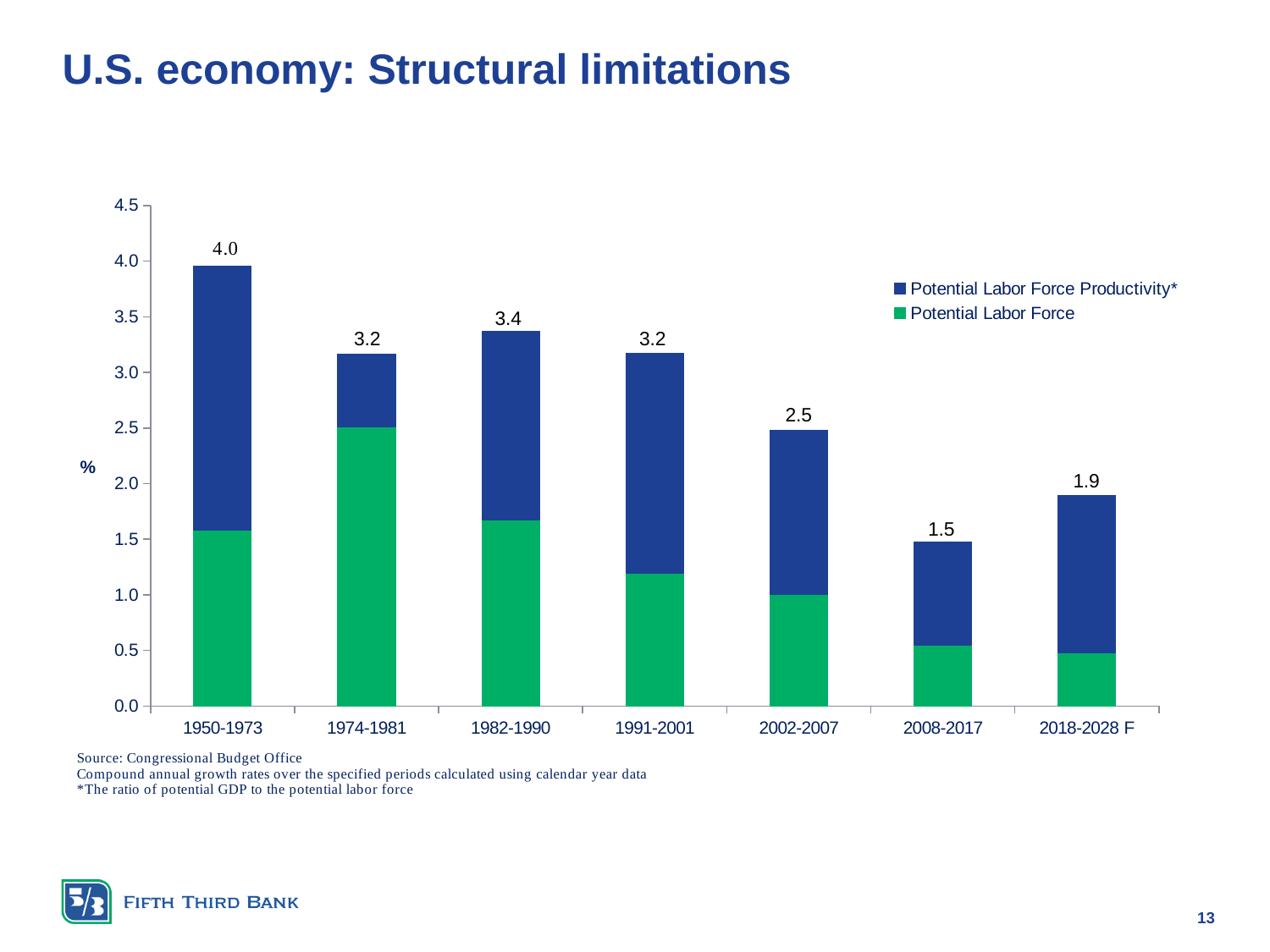
Which period has the lowest total bar? 2008-2017 Which has a larger total, 1982-1990 or 1991-2001? 1982-1990 Is the Potential Labor Force value for 1974-1981 greater or less than 2.0? greater How many time periods are shown on the x axis? 7 What is the total labeled on the bar for 1950-1973? 4.0 Which period has the highest total bar? 1950-1973 What is the total labeled on the bar for 2018-2028 F? 1.9 How many series does the legend list? 2 What kind of chart is shown on the slide? Stacked bar chart What is the total labeled on the bar for 2008-2017? 1.5 What is the difference between the total for 1950-1973 and the total for 2002-2007? 1.5 Is the Potential Labor Force value for 2008-2017 greater or less than 1.0? less